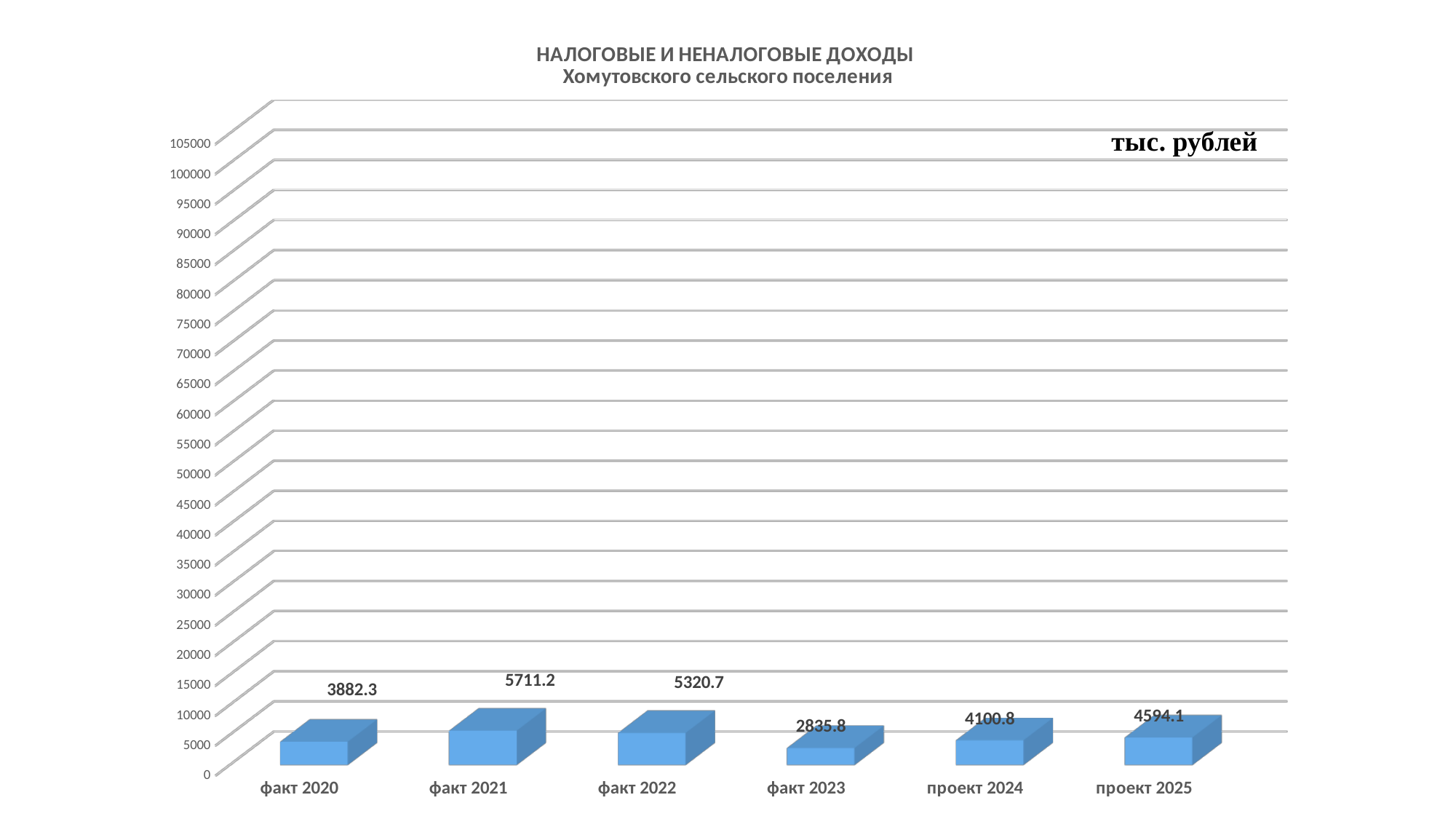
How many categories are shown on the x axis? 6 What unit is indicated in the top right corner of the chart? тыс. рублей What is the difference between the values for проект 2025 and проект 2024? 493.3 What kind of chart is shown on the slide? bar chart What is the value for факт 2023? 2835.8 Which category has the lowest value? факт 2023 What is the value for проект 2025? 4594.1 What is the value for факт 2021? 5711.2 What is the difference between the values for факт 2021 and факт 2022? 390.5 Is the value for факт 2021 greater or less than 10000? less Which category has the highest value? факт 2021 Which is larger, the value for факт 2020 or the value for проект 2024? проект 2024